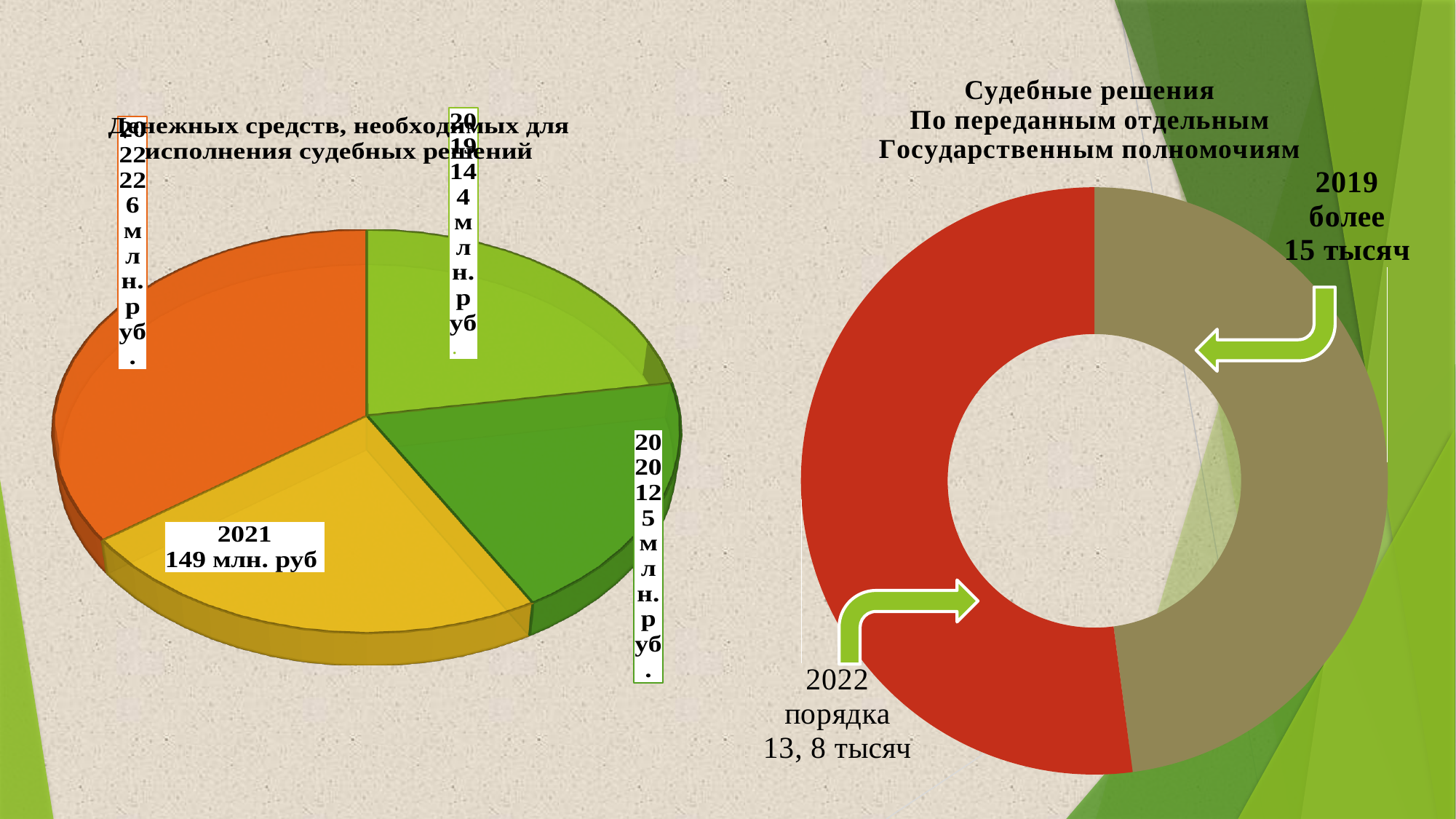
On the left pie chart, what is the value for 2020? 125 млн. руб. On the left pie chart, which year has the smallest slice? 2020 What is the title of the chart on the right of the slide? Судебные решения По переданным отдельным Государственным полномочиям On the left pie chart, which year has the largest slice? 2022 On the left pie chart, what is the value for 2019? 144 млн. руб. How many segments does the right donut chart have? 2 On the left pie chart, what is the value for 2022? 226 млн. руб. What kind of chart is the chart on the left of the slide? Pie chart How many slices does the left pie chart have? 4 On the left pie chart, which is larger, the value for 2019 or the value for 2020? 2019 On the left pie chart, what is the difference between the values for 2022 and 2021? 77 млн. руб. On the left pie chart, what is the value for 2021? 149 млн. руб